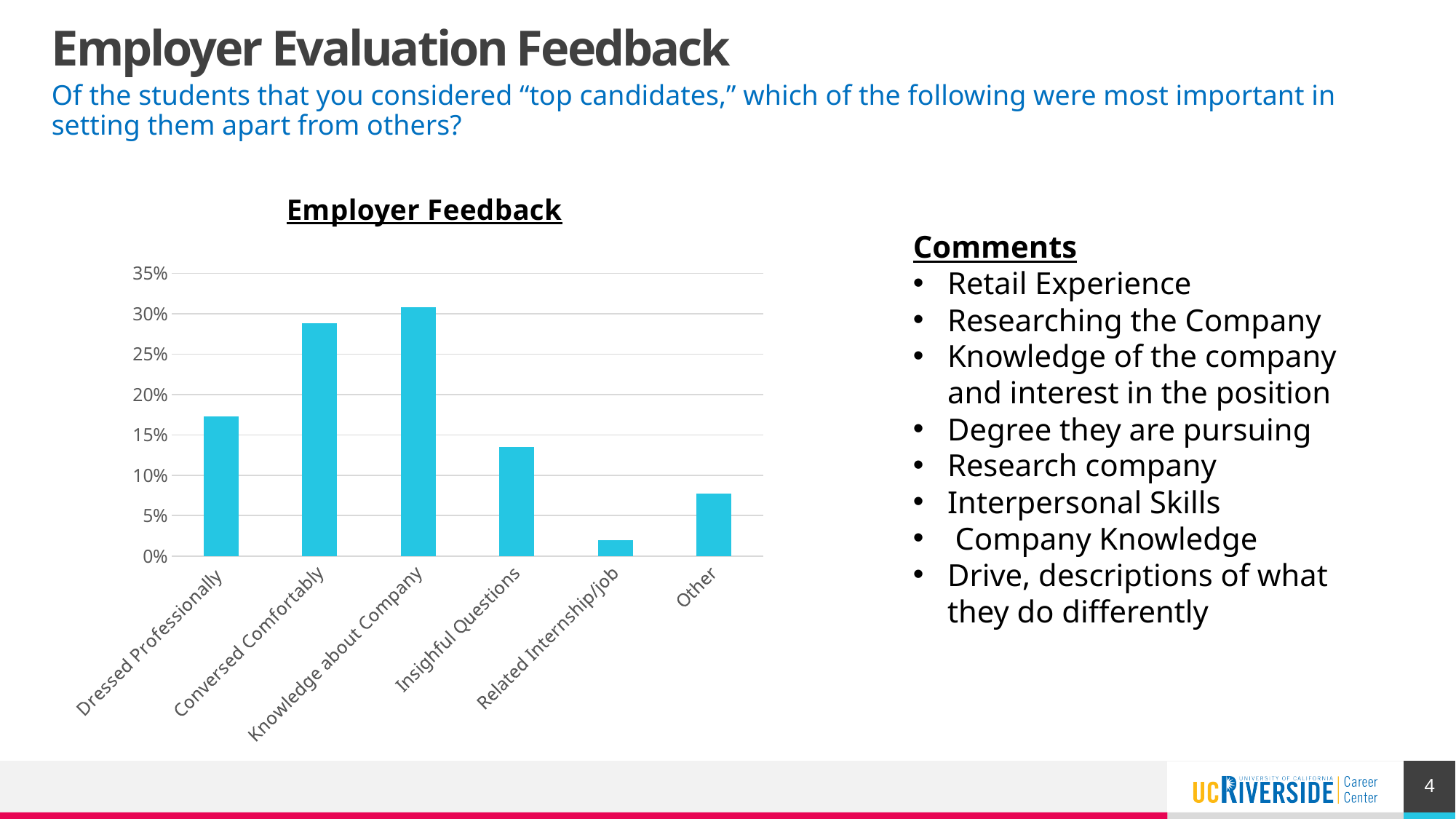
Is the value for Dressed Professionally greater or less than 15%? greater Which category has the highest value in the chart? Knowledge about Company What is the title of the chart? Employer Feedback Which category has the lowest value in the chart? Related Internship/job Is the value for Other greater or less than 5%? greater What kind of chart is shown on the slide? bar chart Is the value for Conversed Comfortably greater or less than 30%? less How many categories are shown on the x axis of the chart? 6 Which is larger, the value for Other or the value for Related Internship/job? Other Which is larger, the value for Dressed Professionally or the value for Insightful Questions? Dressed Professionally